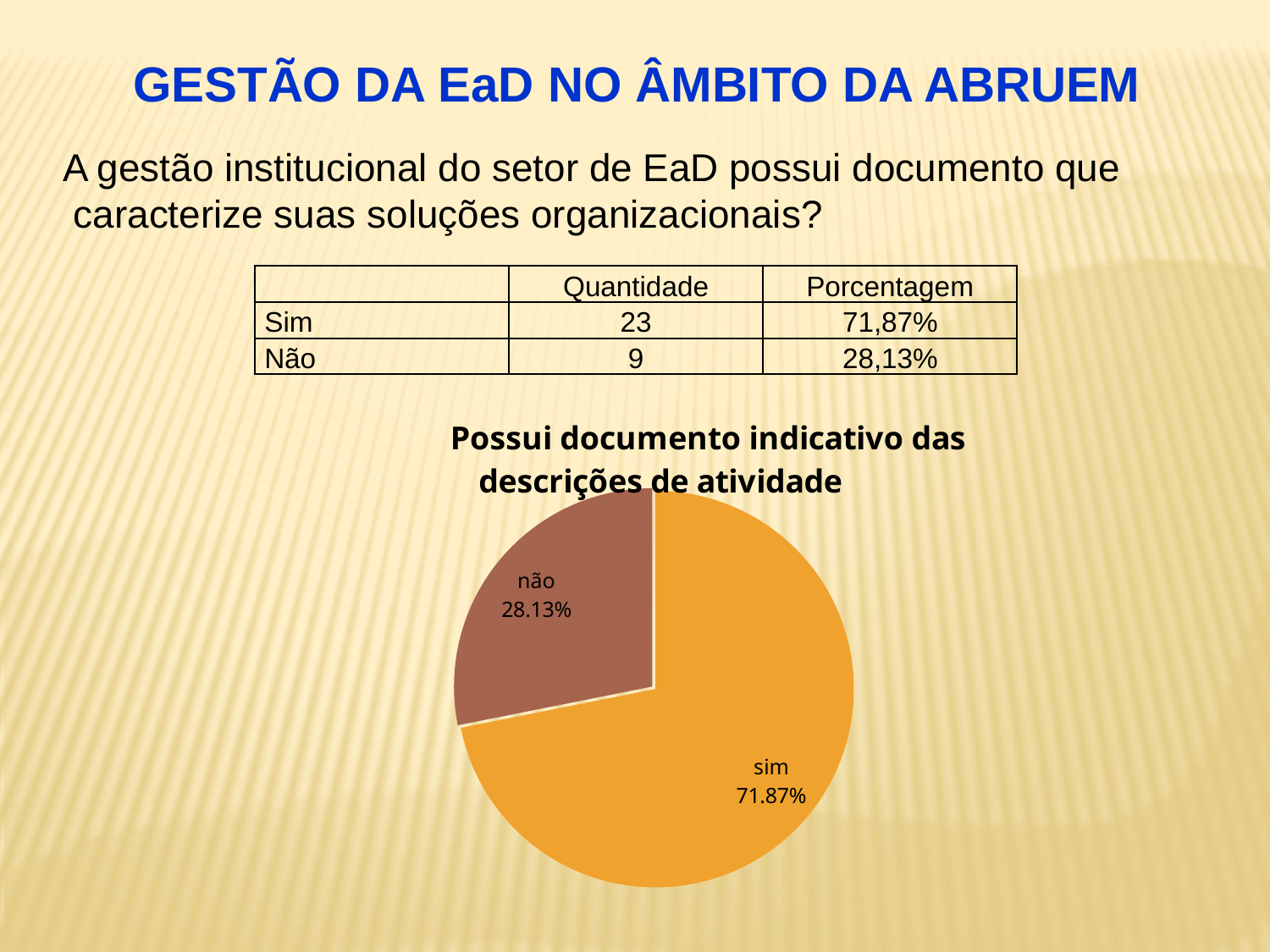
How many slices does the pie chart have? 2 What share of the pie does the "sim" slice represent? 71.87% What is the title of the chart? Possui documento indicativo das descrições de atividade Which is larger, the "sim" slice or the "não" slice? sim What kind of chart is shown on the slide? pie chart What share of the pie does the "não" slice represent? 28.13% Which slice of the pie is the smallest? não What colour is the "sim" slice of the pie? orange Which slice of the pie is the largest? sim What is the difference in percentage points between the "sim" and "não" slices? 43.74 Is the share of the "sim" slice greater or less than 50%? greater